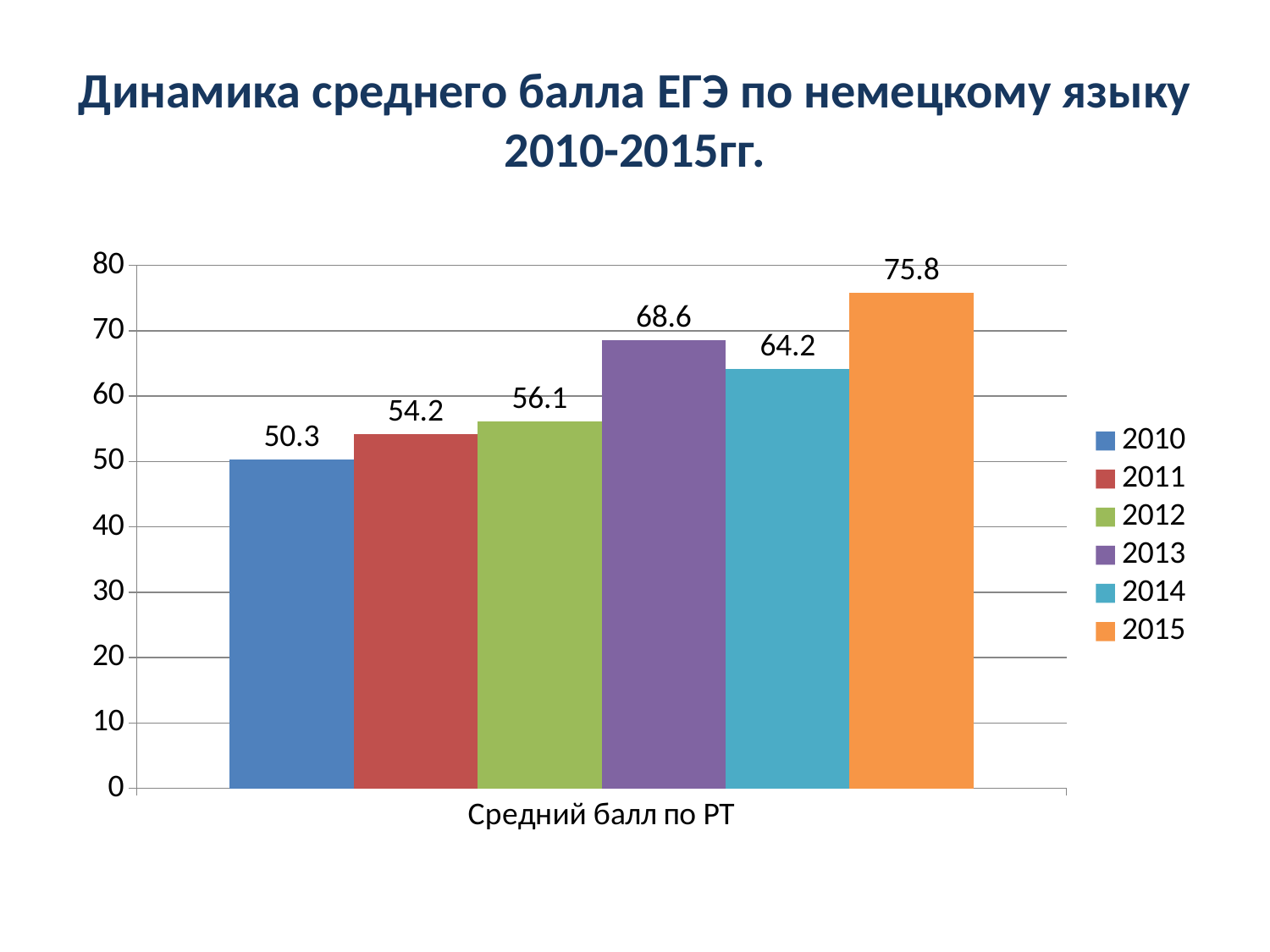
What is the difference between the 2015 and 2010 average scores? 25.5 What is the average score for 2013? 68.6 What is the difference between the 2013 and 2014 average scores? 4.4 What is the label on the x axis of the chart? Средний балл по РТ What is the average score for 2010? 50.3 Is the value for 2012 greater or less than 60? less Which year has the highest average score? 2015 What kind of chart is shown on the slide? bar chart Which year has the lowest average score? 2010 How many series does the legend list? 6 What is the average score for 2015? 75.8 Which is larger, the average score for 2013 or for 2014? 2013